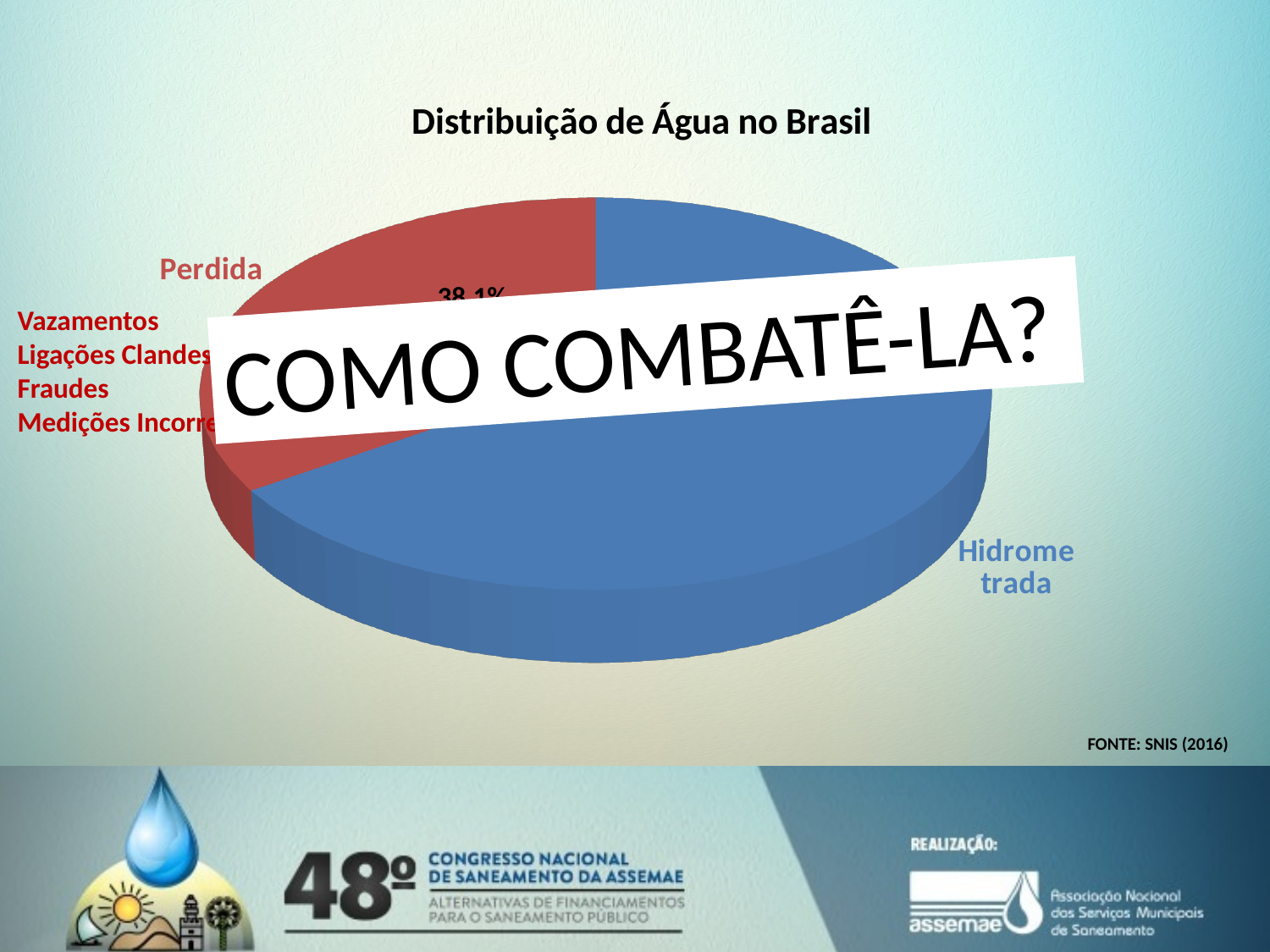
What colour is the Perdida slice of the pie chart? Red Which slice is larger, Perdida or Hidrometrada? Hidrometrada Which slice of the pie chart is the smallest? Perdida Does the Perdida slice represent more or less than half of the pie? Less Does the Hidrometrada slice represent more or less than half of the pie? More Which slice of the pie chart is the largest? Hidrometrada How many slices does the pie chart have? 2 What is the title of the chart? Distribuição de Água no Brasil What kind of chart is shown on the slide? Pie chart